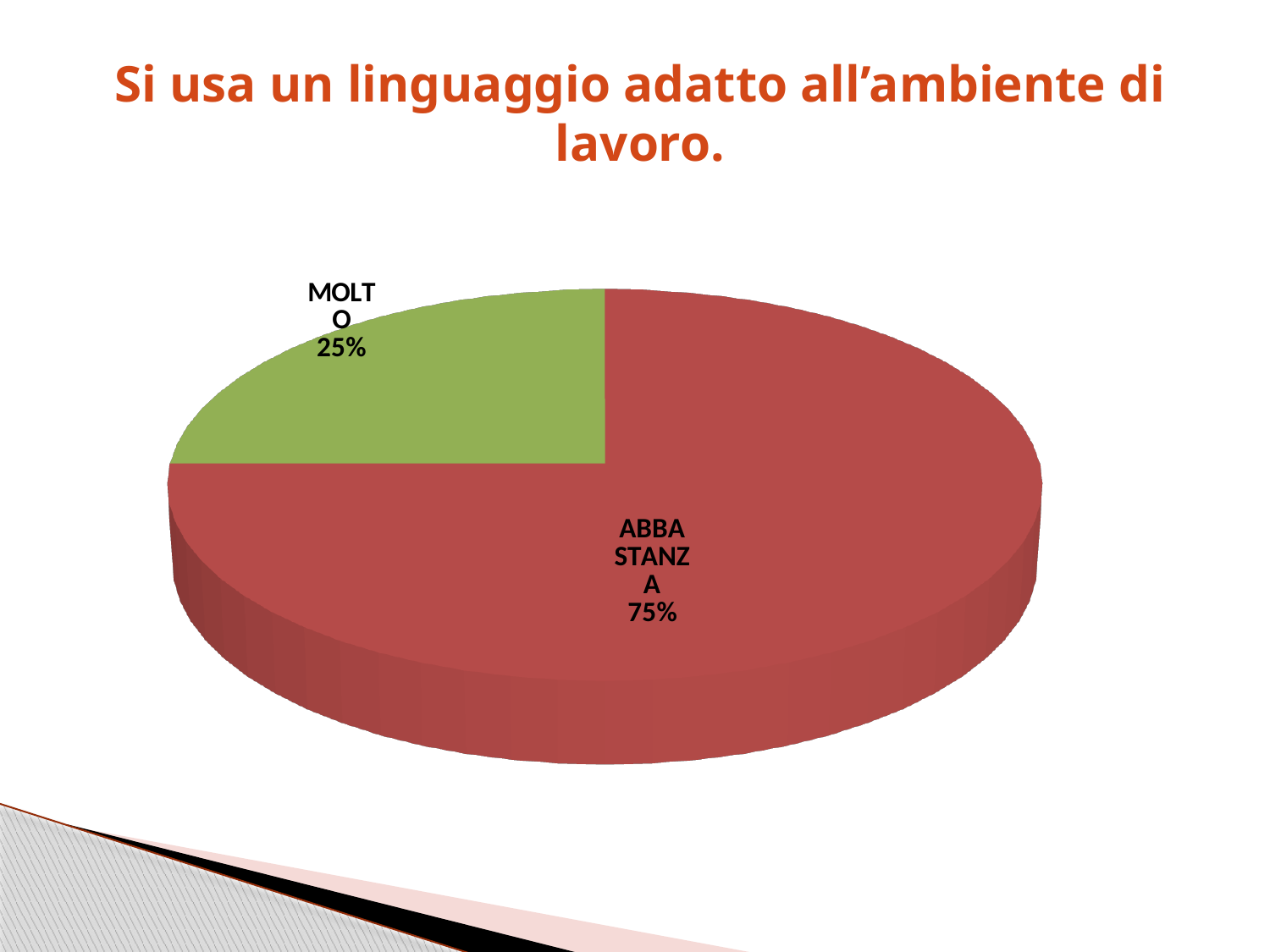
How many slices does the pie chart have? 2 What type of chart is shown on the slide? pie chart Which slice of the pie is the smallest? MOLTO What is the title of the slide containing the pie chart? Si usa un linguaggio adatto all'ambiente di lavoro. Which slice of the pie is the largest? ABBASTANZA What colour is the MOLTO slice of the pie? green Which is larger, the MOLTO slice or the ABBASTANZA slice? ABBASTANZA What is the difference in percentage points between the ABBASTANZA and MOLTO slices? 50 What share of the pie does the MOLTO slice represent? 25% What share of the pie does the ABBASTANZA slice represent? 75%